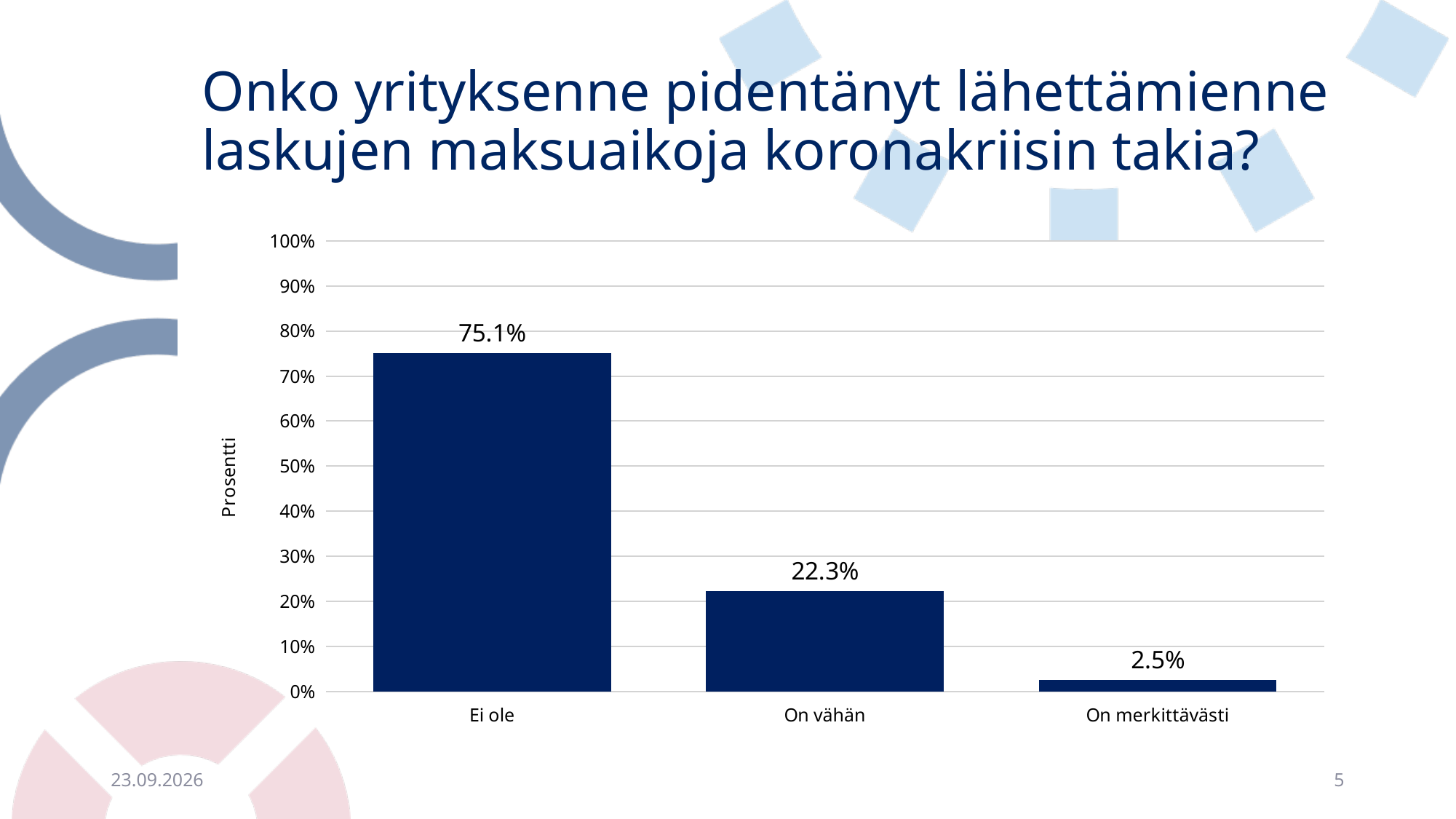
How many categories are shown on the x axis? 3 What kind of chart is shown on the slide? bar chart What is the value for "On vähän"? 22.3% What is the value for "Ei ole"? 75.1% What is the difference between the values for "Ei ole" and "On vähän"? 52.8% Which category has the lowest value? On merkittävästi Which category has the highest value? Ei ole What is the label of the y axis? Prosentti Which is larger, the value for "On vähän" or the value for "On merkittävästi"? On vähän What is the value for "On merkittävästi"? 2.5% What is the difference between the values for "On vähän" and "On merkittävästi"? 19.8% Is the value for "Ei ole" greater or less than 70%? greater